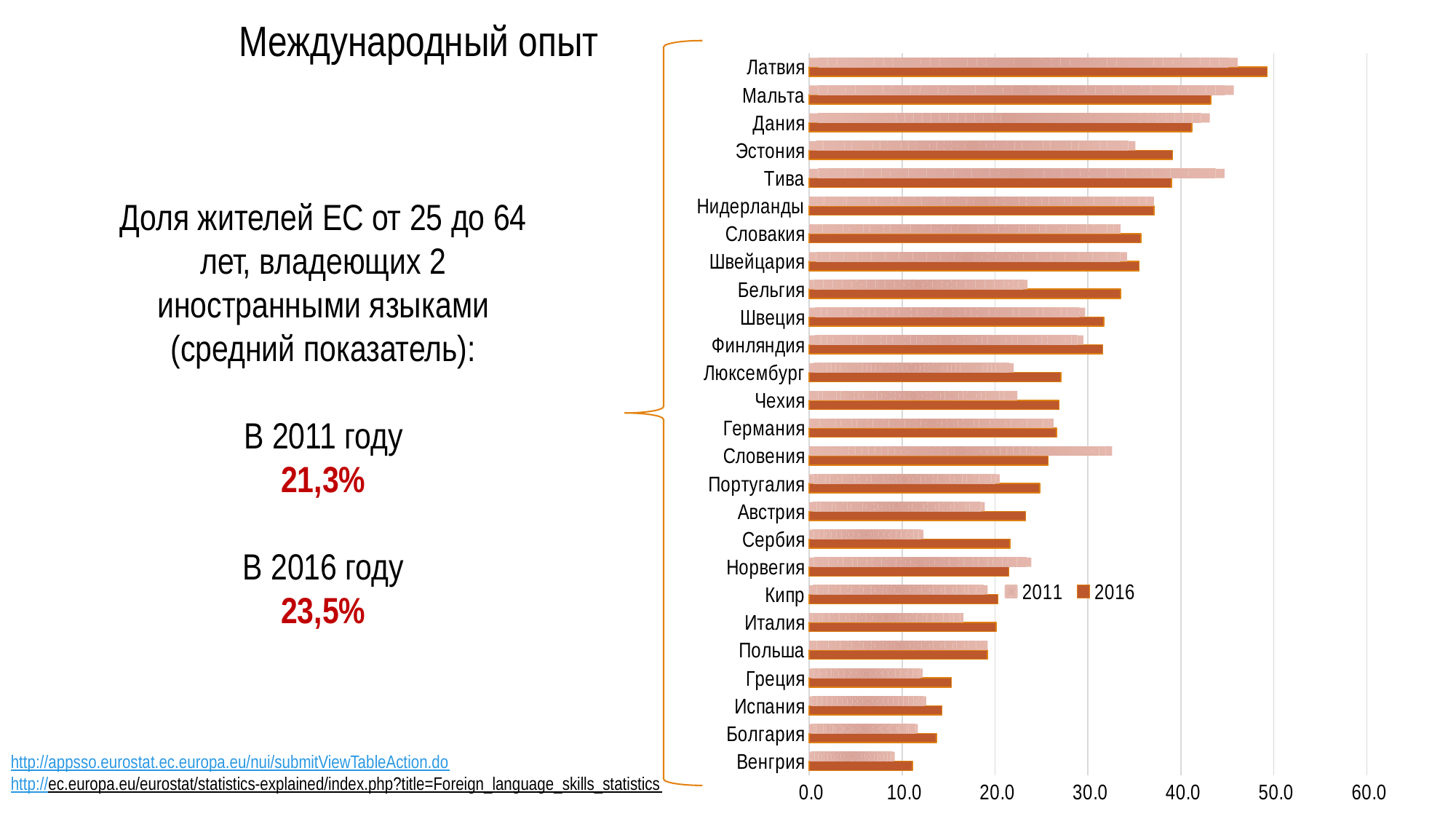
Which country has the lowest 2011 value on the chart? Венгрия Which country has the highest 2016 value on the chart? Латвия What are the two series named in the chart legend? 2011 and 2016 What kind of chart is shown on the slide? bar chart How many series does the chart legend list? 2 For Бельгия, which is larger: the 2011 value or the 2016 value? 2016 Is the 2011 value for Сербия greater or less than 20? less Is the 2011 value for Словения greater or less than 30? greater For Тива, which is larger: the 2011 value or the 2016 value? 2011 Is the 2016 value for Латвия greater or less than 40? greater How many countries are listed on the chart's vertical axis? 26